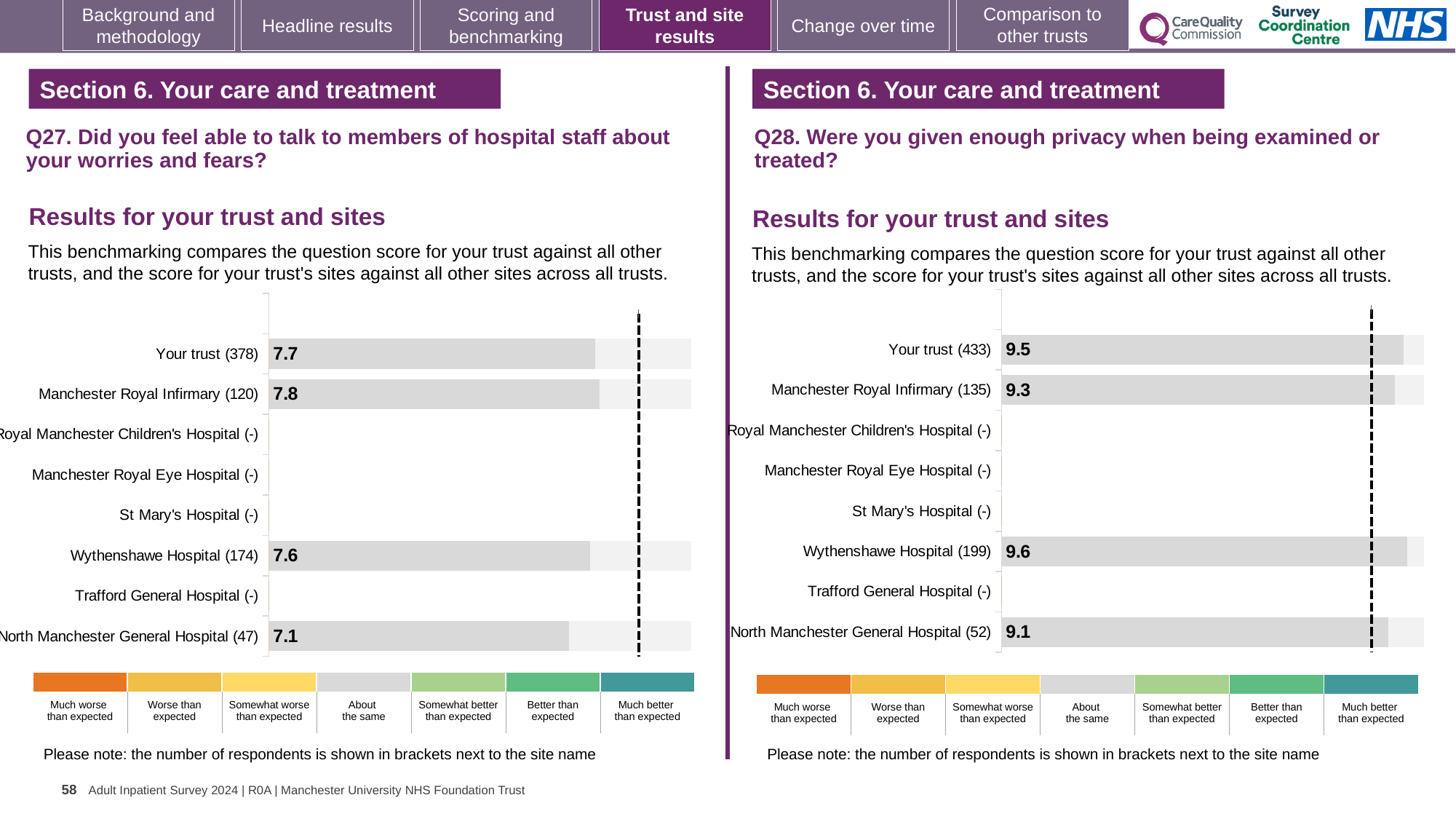
In the Q28 chart on the right, which is larger: the score for Your trust (433) or for Manchester Royal Infirmary (135)? Your trust (433) What kind of chart is the Q28 chart on the right? Bar chart In the Q28 chart on the right, what is the score for Manchester Royal Infirmary (135)? 9.3 In the Q27 chart on the left, which site with a plotted score has the lowest score? North Manchester General Hospital (47) In the Q28 chart on the right, what is the difference between the scores for Your trust (433) and North Manchester General Hospital (52)? 0.4 How many categories are listed on the y axis of the Q27 chart on the left? 8 In the Q27 chart on the left, which site with a plotted score has the highest score? Manchester Royal Infirmary (120) In the Q28 chart on the right, which site with a plotted score has the lowest score? North Manchester General Hospital (52) In the Q27 chart on the left, what is the difference between the scores for Manchester Royal Infirmary (120) and North Manchester General Hospital (47)? 0.7 In the Q28 chart on the right, what is the score for Wythenshawe Hospital (199)? 9.6 In the Q27 chart on the left, what is the score for Your trust (378)? 7.7 In the Q27 chart on the left, what is the score for North Manchester General Hospital (47)? 7.1